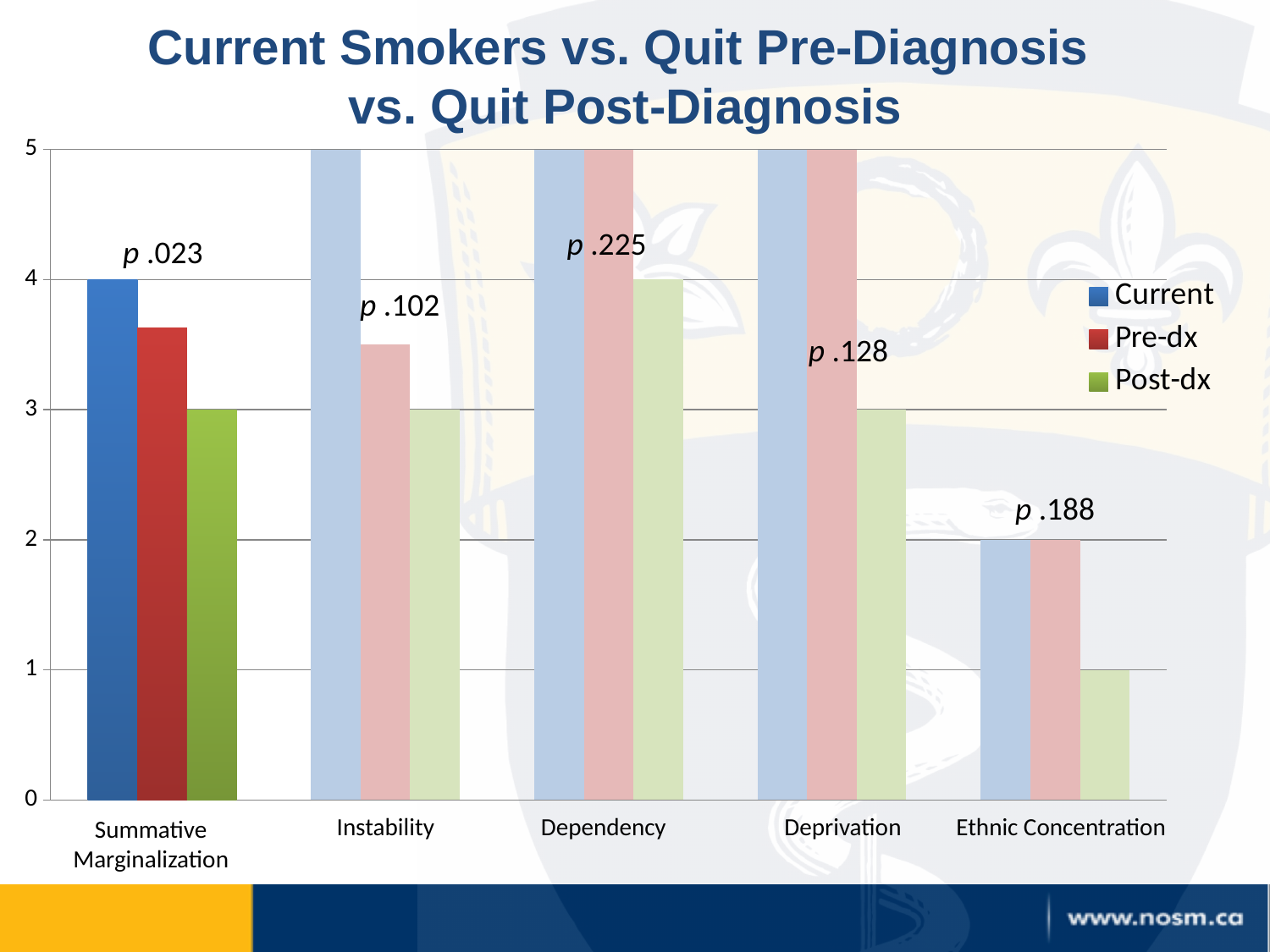
How many categories are shown on the x axis? 5 How many series does the legend list? 3 What kind of chart is shown on the slide? bar chart Is the value for Pre-dx in the Summative Marginalization category greater or less than 3? greater What is the value for Current in the Ethnic Concentration category? 2 What is the difference between the Current value and the Post-dx value in the Deprivation category? 2 What is the value for Current in the Summative Marginalization category? 4 Which category has the lowest Current value? Ethnic Concentration Is the value for Pre-dx in the Instability category greater or less than 4? less What is the value for Post-dx in the Dependency category? 4 Which is larger in the Deprivation category, the Current value or the Post-dx value? Current What is the value for Post-dx in the Ethnic Concentration category? 1